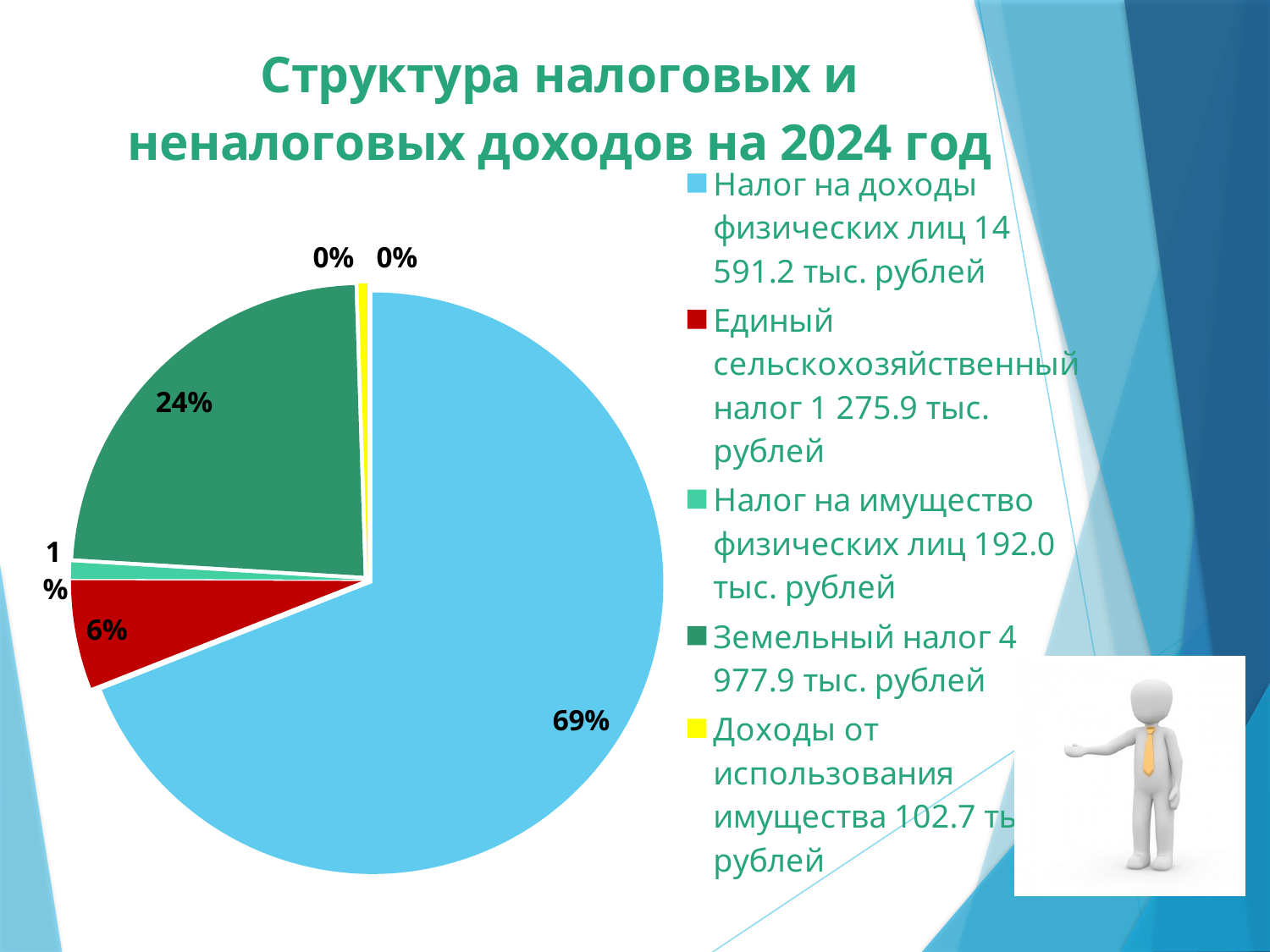
What share of the pie does the slice for Земельный налог (dark green) represent? 24% What share of the pie does the slice for Налог на имущество физических лиц (light green) represent? 1% What share of the pie does the slice for Доходы от использования имущества (yellow) represent? 0% What colour is the slice for Единый сельскохозяйственный налог? red How many entries does the legend list? 5 Which slice is larger: Земельный налог or Единый сельскохозяйственный налог? Земельный налог What is the difference in percentage points between the Налог на доходы физических лиц slice and the Земельный налог slice? 45 What is the title of the chart? Структура налоговых и неналоговых доходов на 2024 год What kind of chart is shown on the slide? pie chart Which category has the largest slice of the pie? Налог на доходы физических лиц